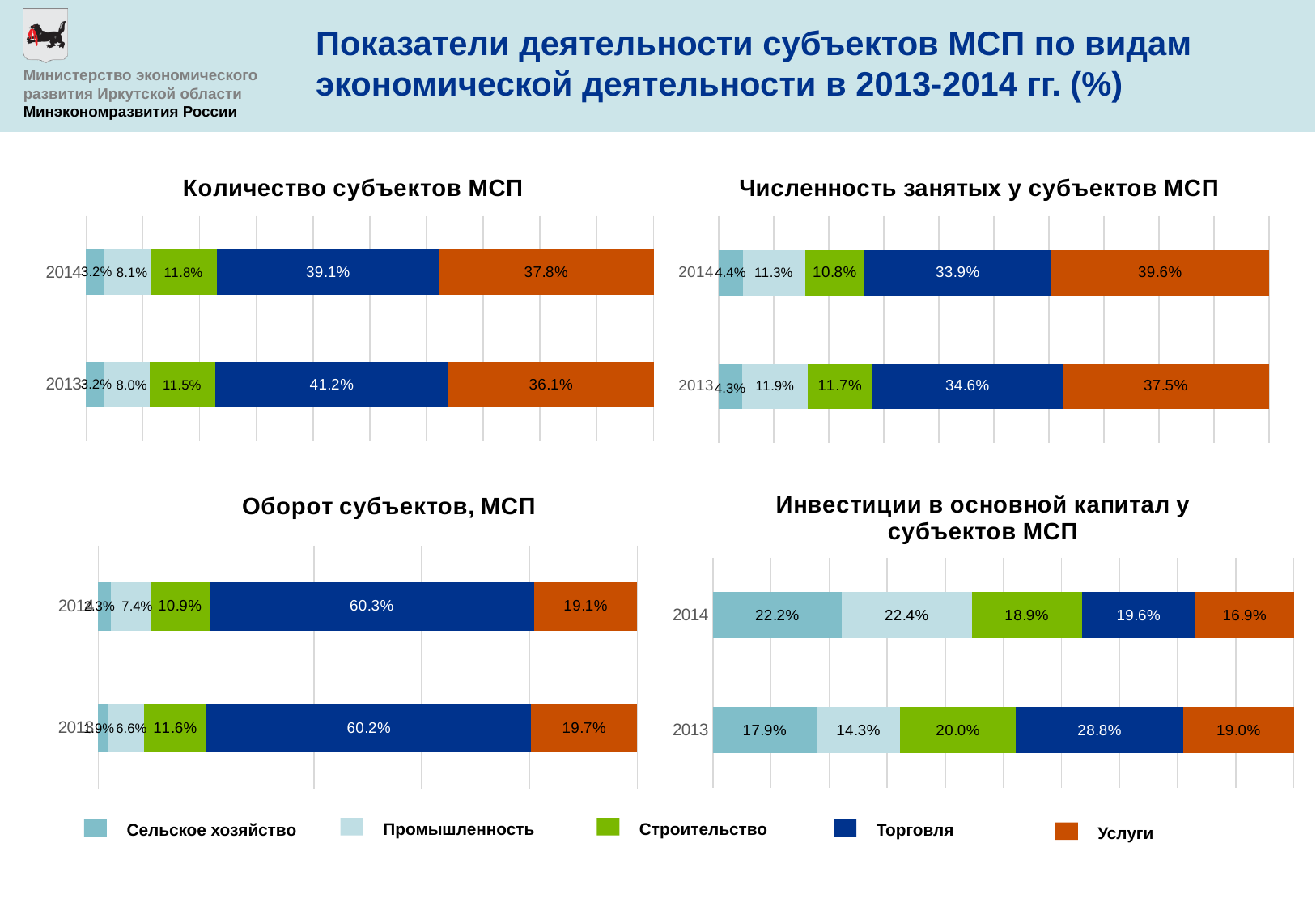
In the chart 'Оборот субъектов, МСП', what is the value for Торговля in 2014? 60.3% How many series does the legend at the bottom of the slide list? 5 How many years (categories) are shown in the chart 'Оборот субъектов, МСП'? 2 In the chart 'Количество субъектов МСП', what is the value for Торговля in 2014? 39.1% In the chart 'Инвестиции в основной капитал у субъектов МСП', what is the value for Торговля in 2013? 28.8% In the chart 'Инвестиции в основной капитал у субъектов МСП', which segment is the largest in the 2014 bar? Промышленность In the chart 'Численность занятых у субъектов МСП', what is the value for Услуги in 2014? 39.6% In the chart 'Численность занятых у субъектов МСП', which segment is the largest in the 2013 bar? Услуги What kind of chart is 'Количество субъектов МСП'? Stacked bar chart In the chart 'Количество субъектов МСП', what is the value for Услуги in 2013? 36.1% In the chart 'Инвестиции в основной капитал у субъектов МСП', is the Сельское хозяйство value larger in 2013 or 2014? 2014 In the chart 'Оборот субъектов, МСП', what is the difference between the Услуги values for 2013 and 2014? 0.6%